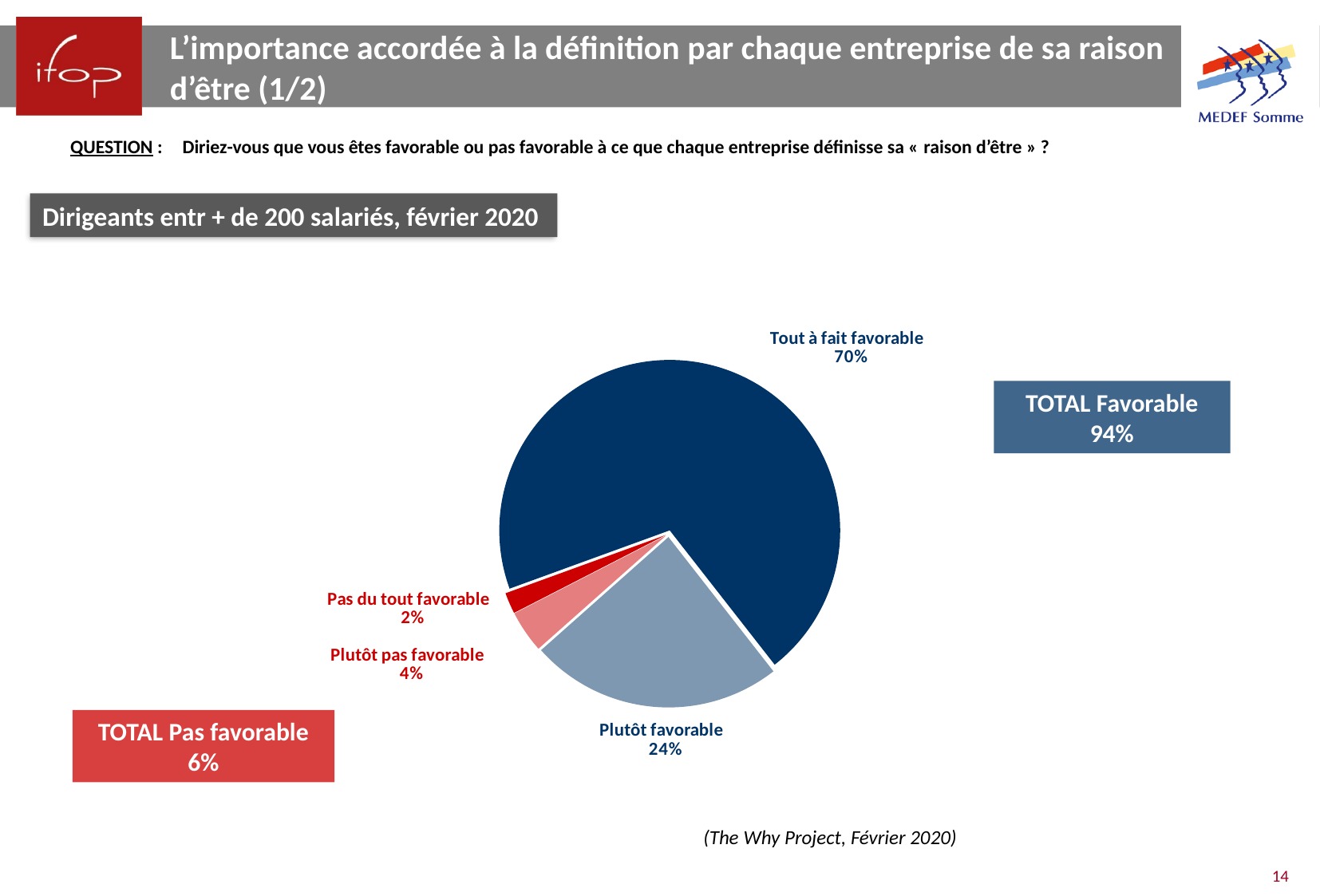
What percentage of respondents answered "Plutôt pas favorable"? 4% How many slices does the pie chart have? 4 What percentage of respondents answered "Plutôt favorable"? 24% Which response category has the smallest share of the pie? Pas du tout favorable What type of chart is shown on the slide? Pie chart What is the difference in percentage points between "Tout à fait favorable" and "Plutôt favorable"? 46 Which response category has the largest share of the pie? Tout à fait favorable What is the TOTAL Pas favorable percentage shown on the slide? 6% What percentage of respondents answered "Tout à fait favorable"? 70% What is the TOTAL Favorable percentage shown on the slide? 94% What percentage of respondents answered "Pas du tout favorable"? 2% Which is larger: the share for "Plutôt pas favorable" or for "Pas du tout favorable"? Plutôt pas favorable